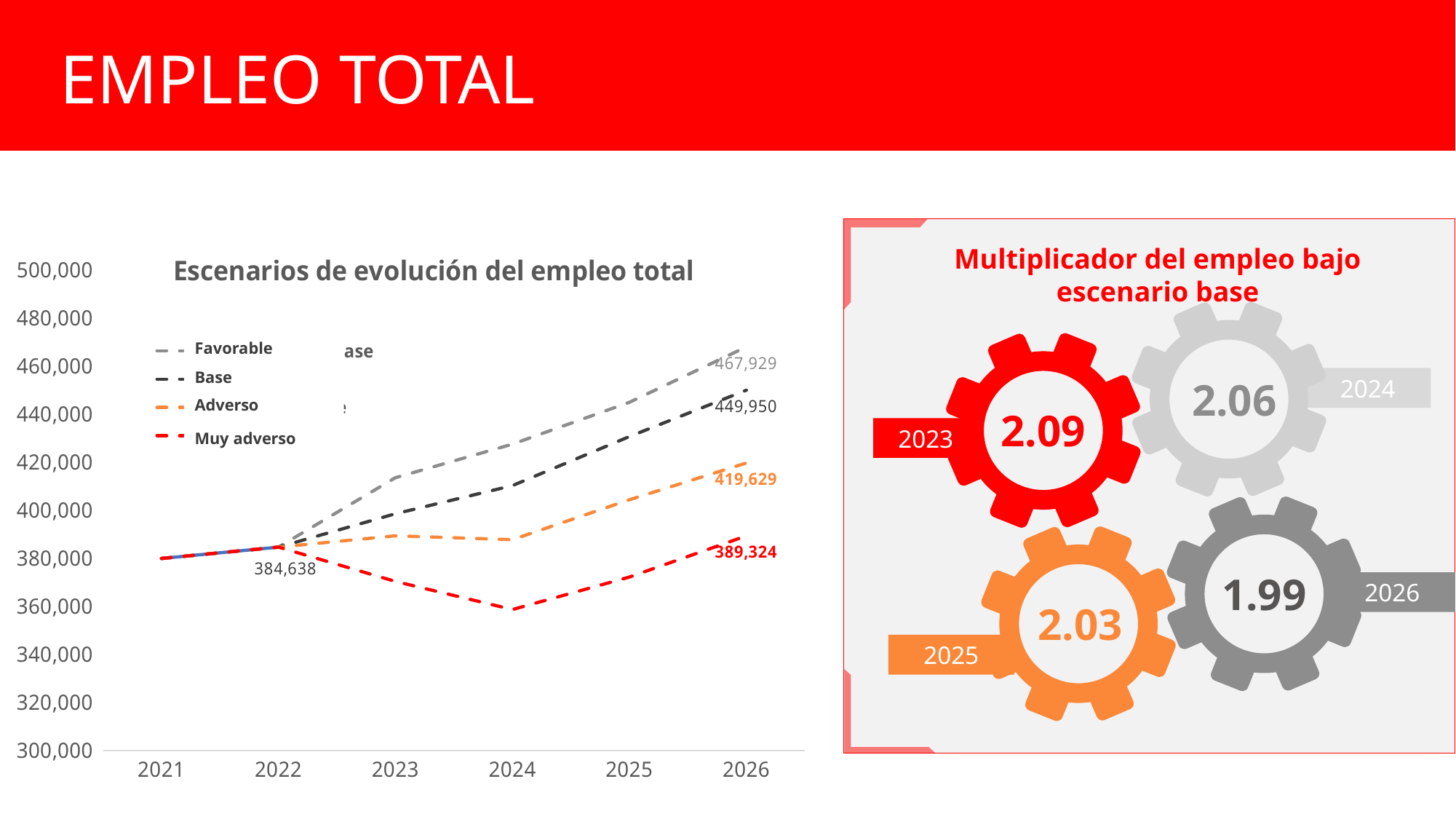
In the chart 'Escenarios de evolución del empleo total', what value is labelled at 2022? 384,638 In the chart 'Escenarios de evolución del empleo total', does the Muy adverso series rise or fall between 2022 and 2024? fall In the chart 'Escenarios de evolución del empleo total', what is the value of the Muy adverso scenario in 2026? 389,324 In the chart 'Escenarios de evolución del empleo total', which scenario has the highest value in 2026? Favorable In the chart 'Escenarios de evolución del empleo total', is the Muy adverso value in 2024 greater or less than 380,000? less What kind of chart is 'Escenarios de evolución del empleo total'? line chart In the chart 'Escenarios de evolución del empleo total', what is the value of the Favorable scenario in 2026? 467,929 How many series does the legend of the chart 'Escenarios de evolución del empleo total' list? 4 In the chart 'Escenarios de evolución del empleo total', which scenario has the lowest value in 2026? Muy adverso In the chart 'Escenarios de evolución del empleo total', what is the value of the Base scenario in 2026? 449,950 In the chart 'Escenarios de evolución del empleo total', what is the value of the Adverso scenario in 2026? 419,629 In the chart 'Escenarios de evolución del empleo total', what is the difference between the Favorable and Base values in 2026? 17,979